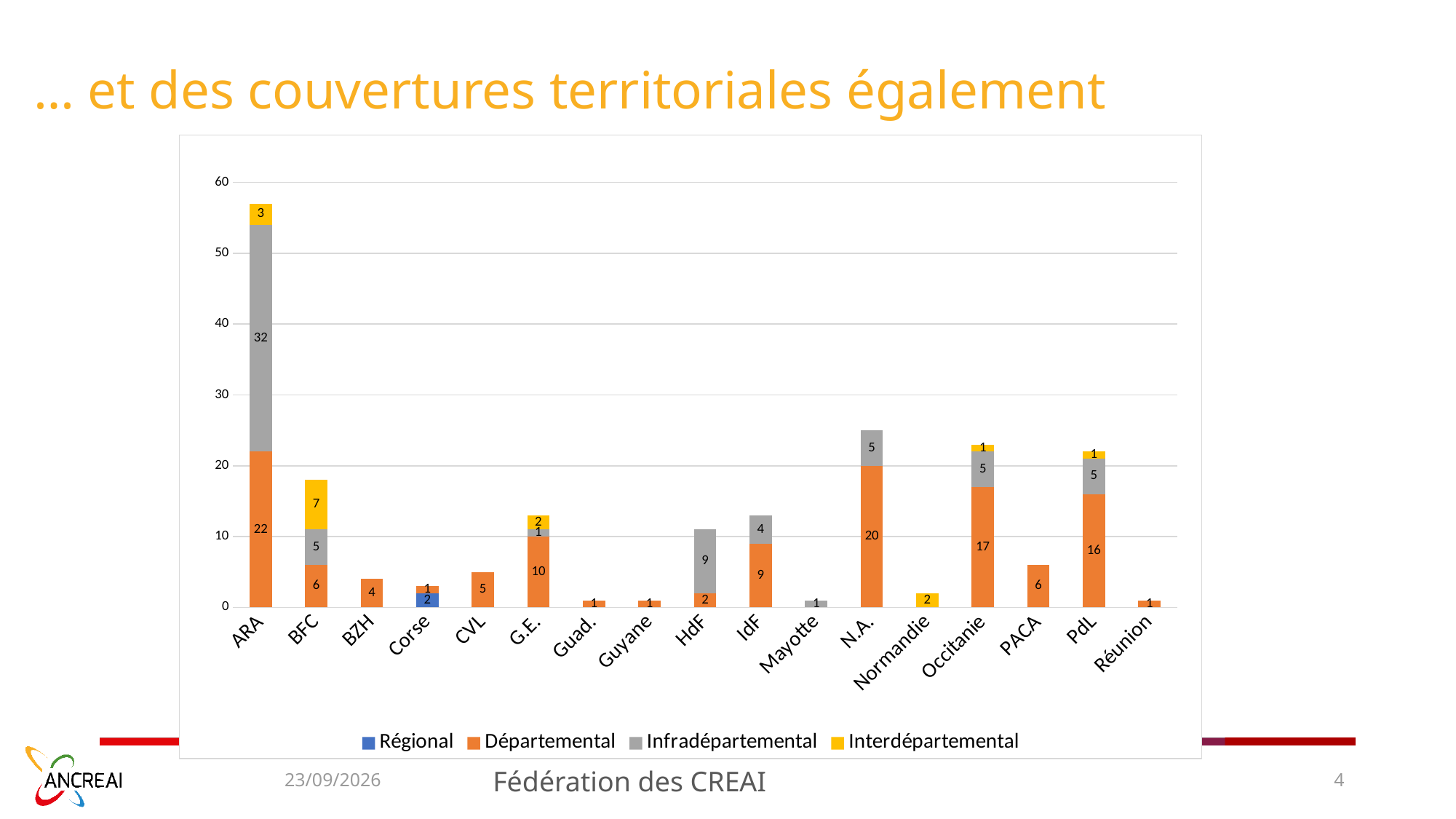
What type of chart is shown on the slide? Stacked bar chart What is the Infradépartemental value for ARA? 32 What is the Interdépartemental value for BFC? 7 How many series does the legend list? 4 How many regions (categories) are shown on the x axis? 17 What is the Régional value for Corse? 2 Which region has the highest total stacked bar? ARA What is the total of the stacked bar for Occitanie? 23 What is the total of the stacked bar for PdL? 22 What is the difference between the Départemental values for Occitanie and PdL? 1 What is the Départemental value for N.A.? 20 Which is larger, the Infradépartemental value for HdF or the Infradépartemental value for IdF? HdF